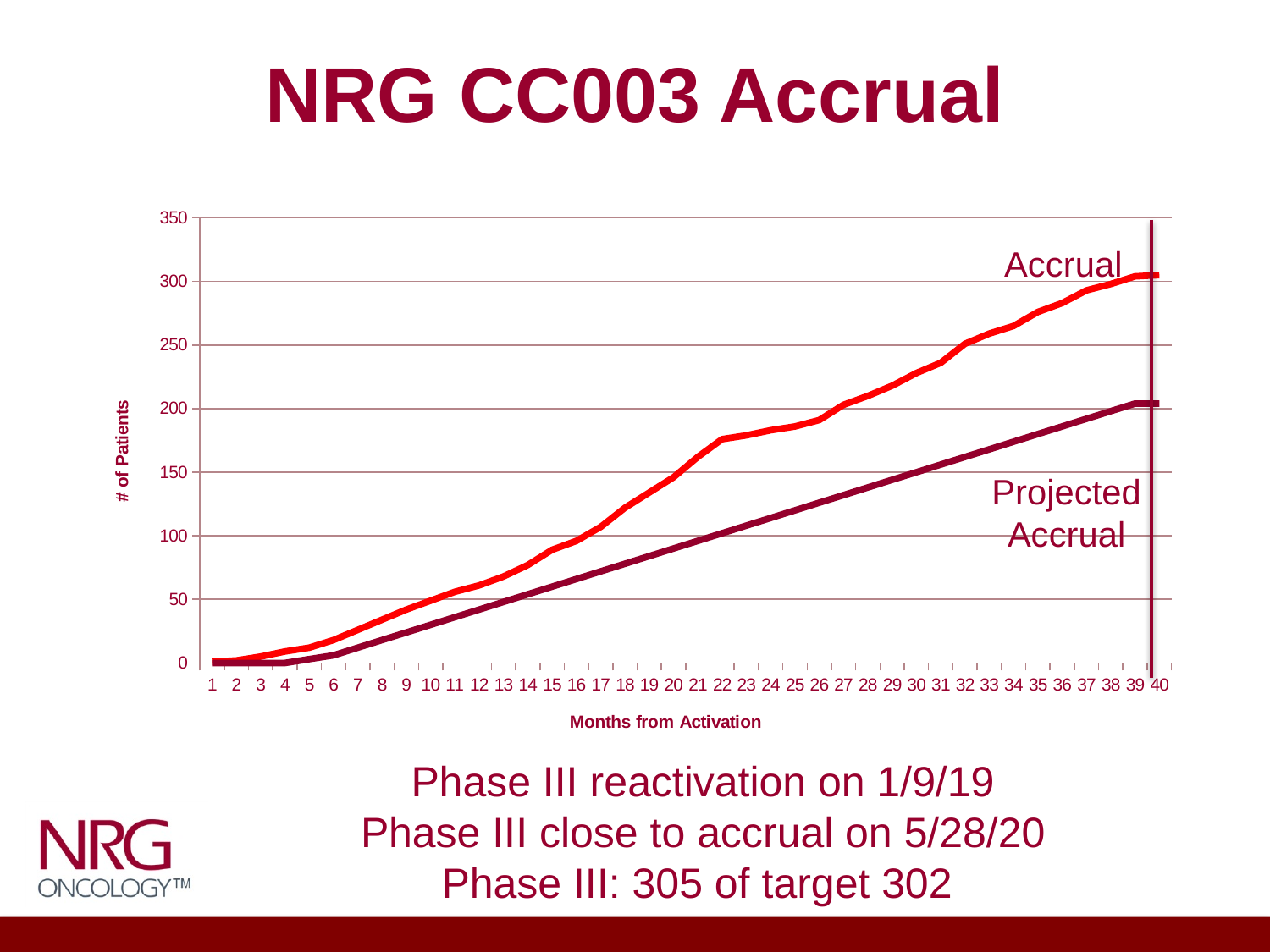
How many months are shown along the x axis of the chart? 40 Does the Accrual line rise or fall as the months from activation increase? rise What is the title of the x axis of the chart? Months from Activation What is the title of the y axis of the chart? # of Patients How many series are plotted on the chart? 2 What kind of chart is shown on the slide? line chart Is the Accrual value at month 40 greater or less than 250? greater Is the Accrual value at month 22 greater or less than 150? greater Is the Accrual value at month 30 greater or less than 200? greater At month 30, which series has the larger value, Accrual or Projected Accrual? Accrual